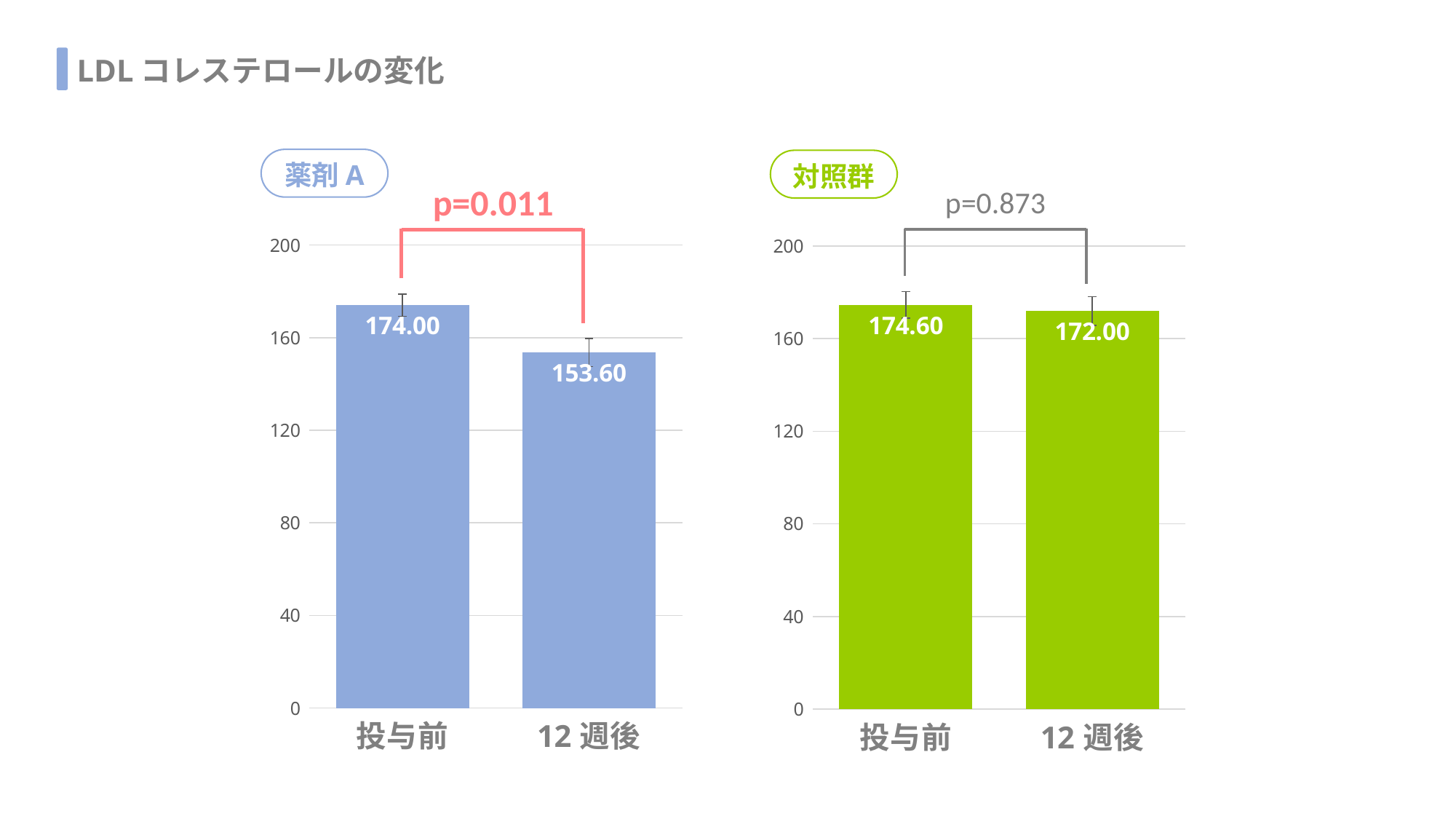
In the 薬剤A chart, what is the value for 12週後? 153.60 In the 対照群 chart, is the value for 12週後 greater or less than 160? greater What p-value is shown above the 薬剤A chart? p=0.011 In the 薬剤A chart, which category has the lower value? 12週後 What kind of chart is the 対照群 chart? bar chart In the 薬剤A chart, is the value for 12週後 greater or less than 160? less In the 対照群 chart, what is the value for 12週後? 172.00 In the 対照群 chart, what is the value for 投与前? 174.60 In the 薬剤A chart, what is the value for 投与前? 174.00 In the 対照群 chart, what is the difference between the 投与前 and 12週後 values? 2.60 In the 薬剤A chart, what is the difference between the 投与前 and 12週後 values? 20.40 How many categories does the 薬剤A chart show? 2